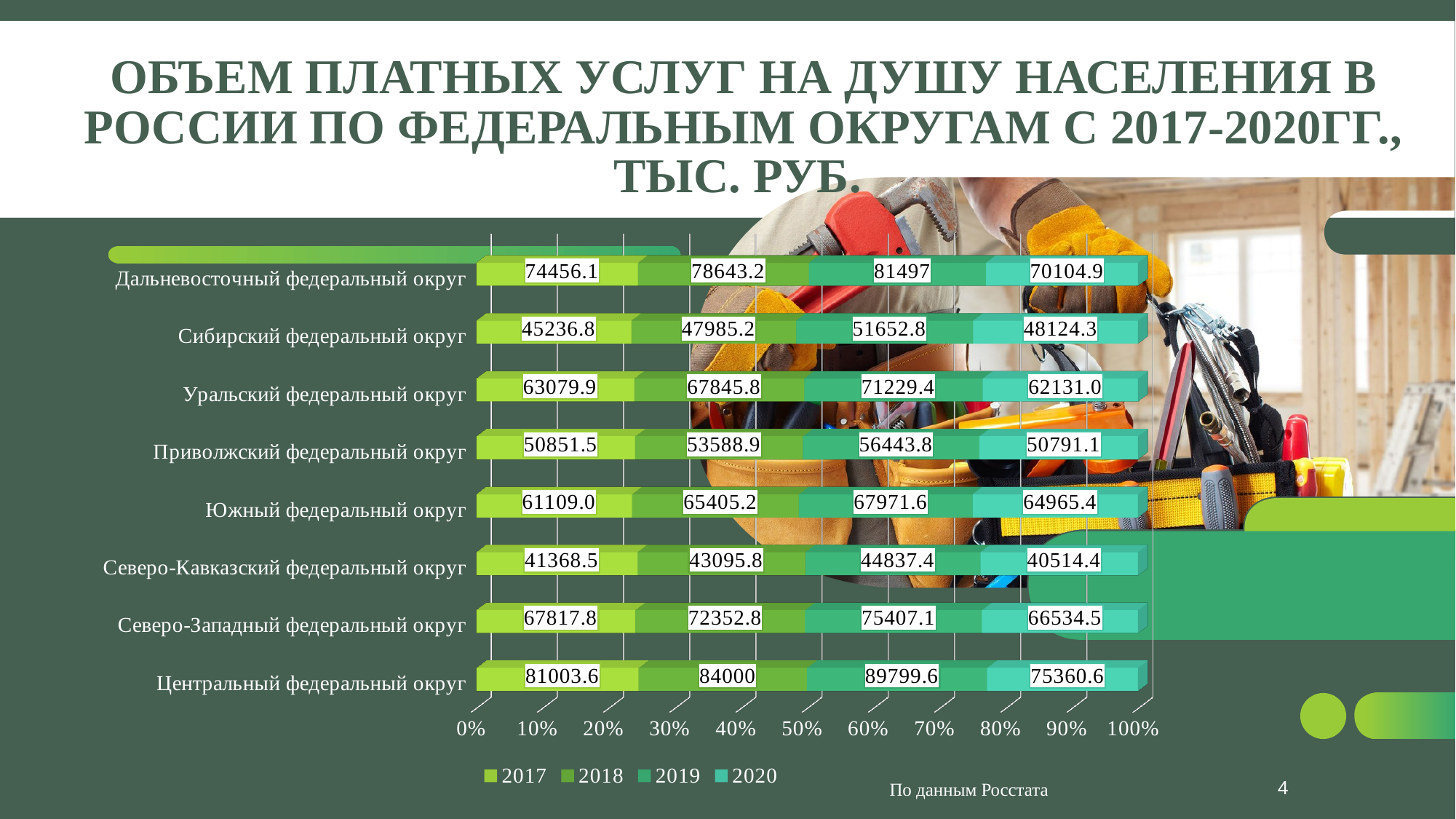
What is the value for Сибирский федеральный округ in 2017? 45236.8 Which federal district has the lowest value in 2018? Северо-Кавказский федеральный округ Which federal district has the highest value in 2019? Центральный федеральный округ What is the difference between the 2019 and 2020 values for Уральский федеральный округ? 9098.4 What kind of chart is shown on the slide? Stacked bar chart Do the values for Приволжский федеральный округ rise or fall from 2017 to 2019? Rise What is the value for Центральный федеральный округ in 2019? 89799.6 How many federal districts are shown on the chart? 8 What is the value for Дальневосточный федеральный округ in 2020? 70104.9 Which is larger in 2019: the value for Южный федеральный округ or for Северо-Западный федеральный округ? Северо-Западный федеральный округ What is the difference between the 2018 and 2017 values for Центральный федеральный округ? 2996.4 How many series does the legend list? 4